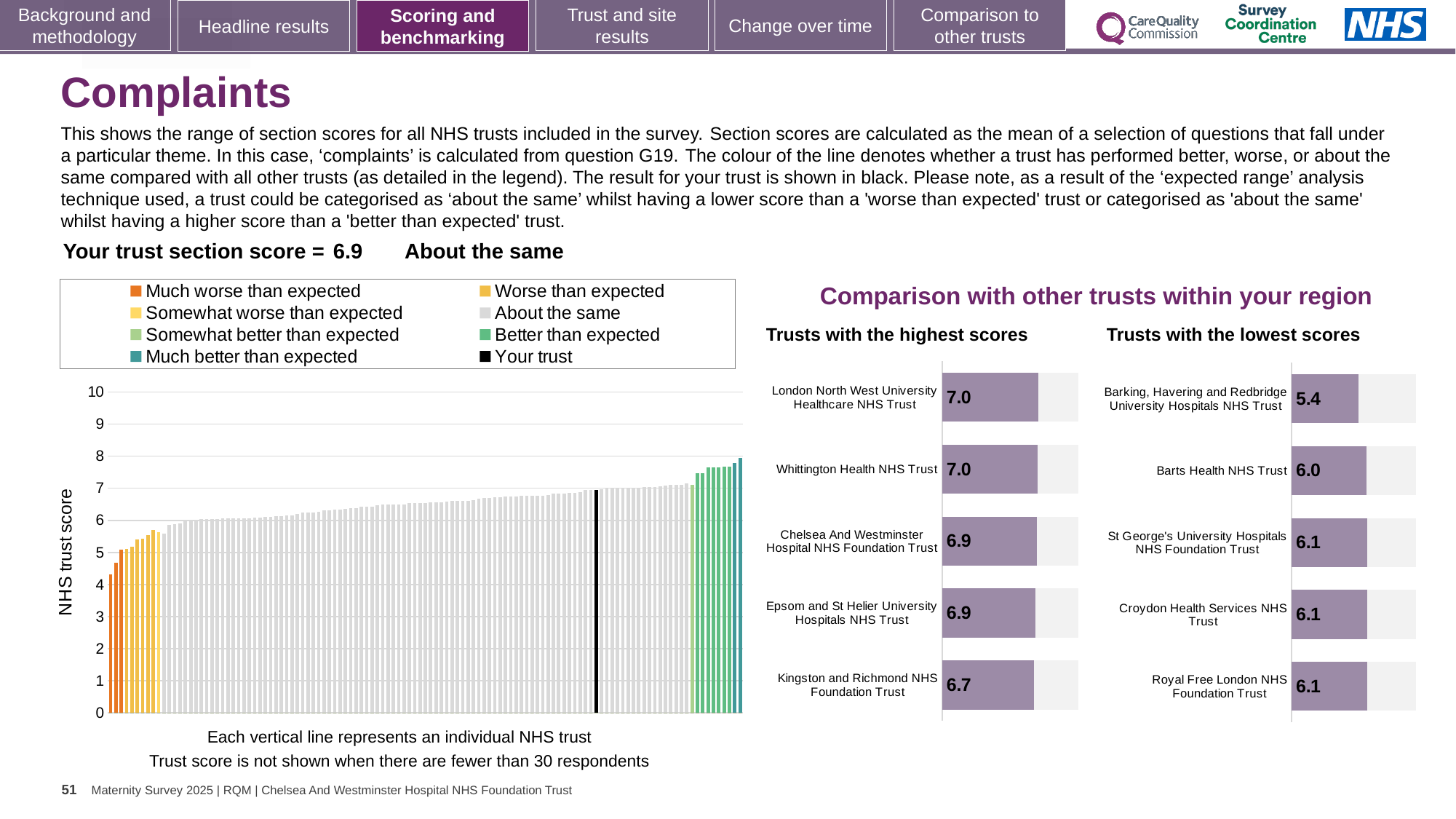
In the 'Trusts with the lowest scores' chart, what is the score for Barts Health NHS Trust? 6.0 In the 'Trusts with the highest scores' chart, what is the score for Kingston and Richmond NHS Foundation Trust? 6.7 In the large chart on the left, is the value of the lowest bar greater or less than 5? less In the 'Trusts with the highest scores' chart, what is the score for London North West University Healthcare NHS Trust? 7.0 How many trusts are shown in the 'Trusts with the lowest scores' chart? 5 In the 'Trusts with the highest scores' chart, which trust has the lowest score? Kingston and Richmond NHS Foundation Trust What type of chart is the large chart on the left with the y-axis labelled 'NHS trust score'? Bar chart In the 'Trusts with the highest scores' chart, which has the larger score: Whittington Health NHS Trust or Kingston and Richmond NHS Foundation Trust? Whittington Health NHS Trust In the 'Trusts with the highest scores' chart, what is the difference between the scores of Whittington Health NHS Trust and Kingston and Richmond NHS Foundation Trust? 0.3 In the 'Trusts with the lowest scores' chart, which trust has the lowest score? Barking, Havering and Redbridge University Hospitals NHS Trust In the 'Trusts with the lowest scores' chart, what is the score for Barking, Havering and Redbridge University Hospitals NHS Trust? 5.4 In the 'Trusts with the lowest scores' chart, what is the difference between the scores of Barts Health NHS Trust and Barking, Havering and Redbridge University Hospitals NHS Trust? 0.6